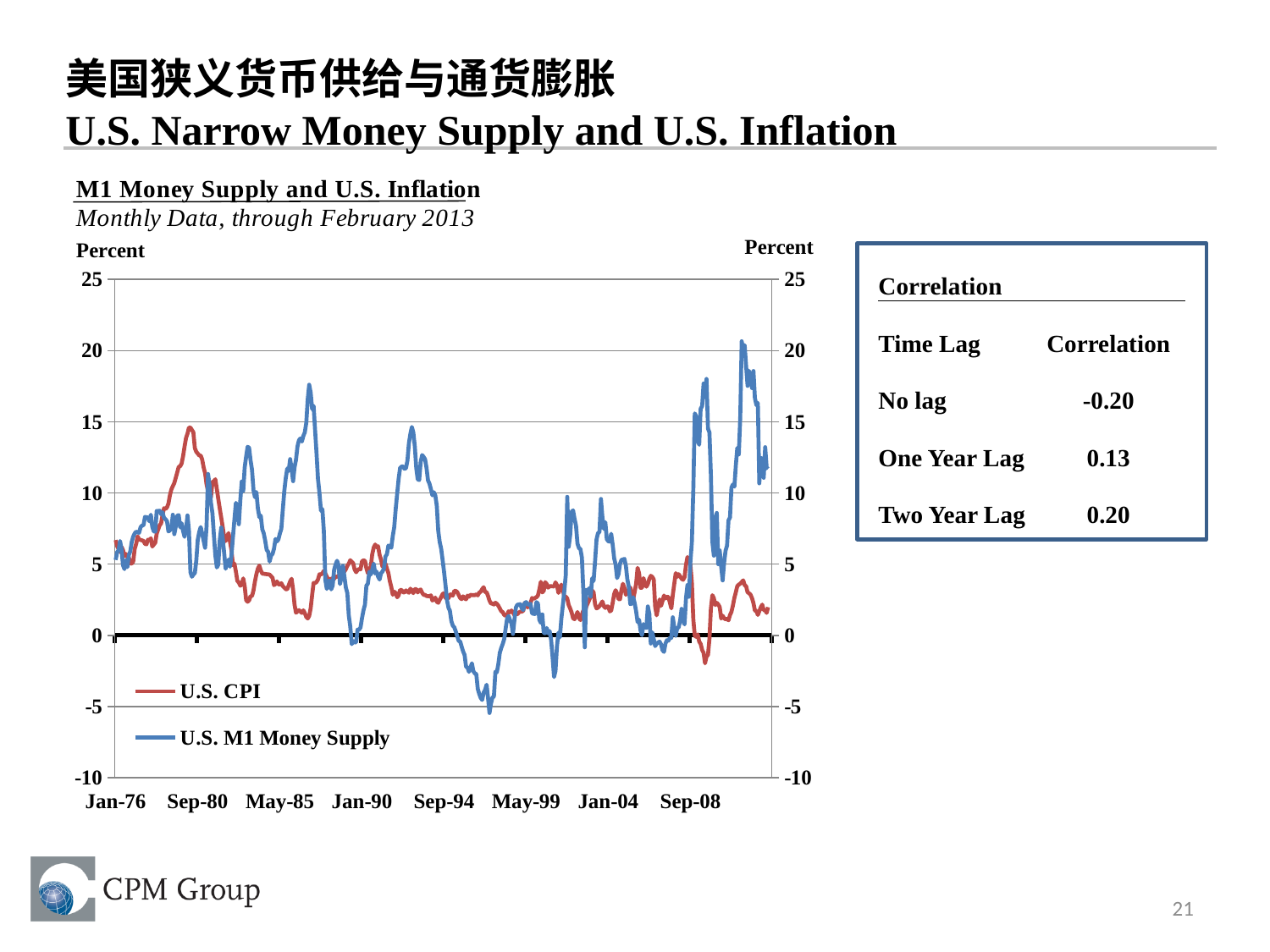
Which series reaches the highest peak on the chart, U.S. CPI or U.S. M1 Money Supply? U.S. M1 Money Supply Is the peak value of U.S. M1 Money Supply around 1985 greater or less than 15? greater Which two series are listed in the chart legend? U.S. CPI and U.S. M1 Money Supply How many series does the chart legend list? 2 What is the title of the chart? M1 Money Supply and U.S. Inflation Is the lowest value of U.S. CPI shortly after Sep-08 greater or less than 0? less Is the peak value of U.S. CPI around 1980 greater or less than 10? greater Does U.S. CPI rise or fall between Sep-80 and May-85? fall What kind of chart is shown on the slide? line chart How many date labels are shown on the x axis of the chart? 8